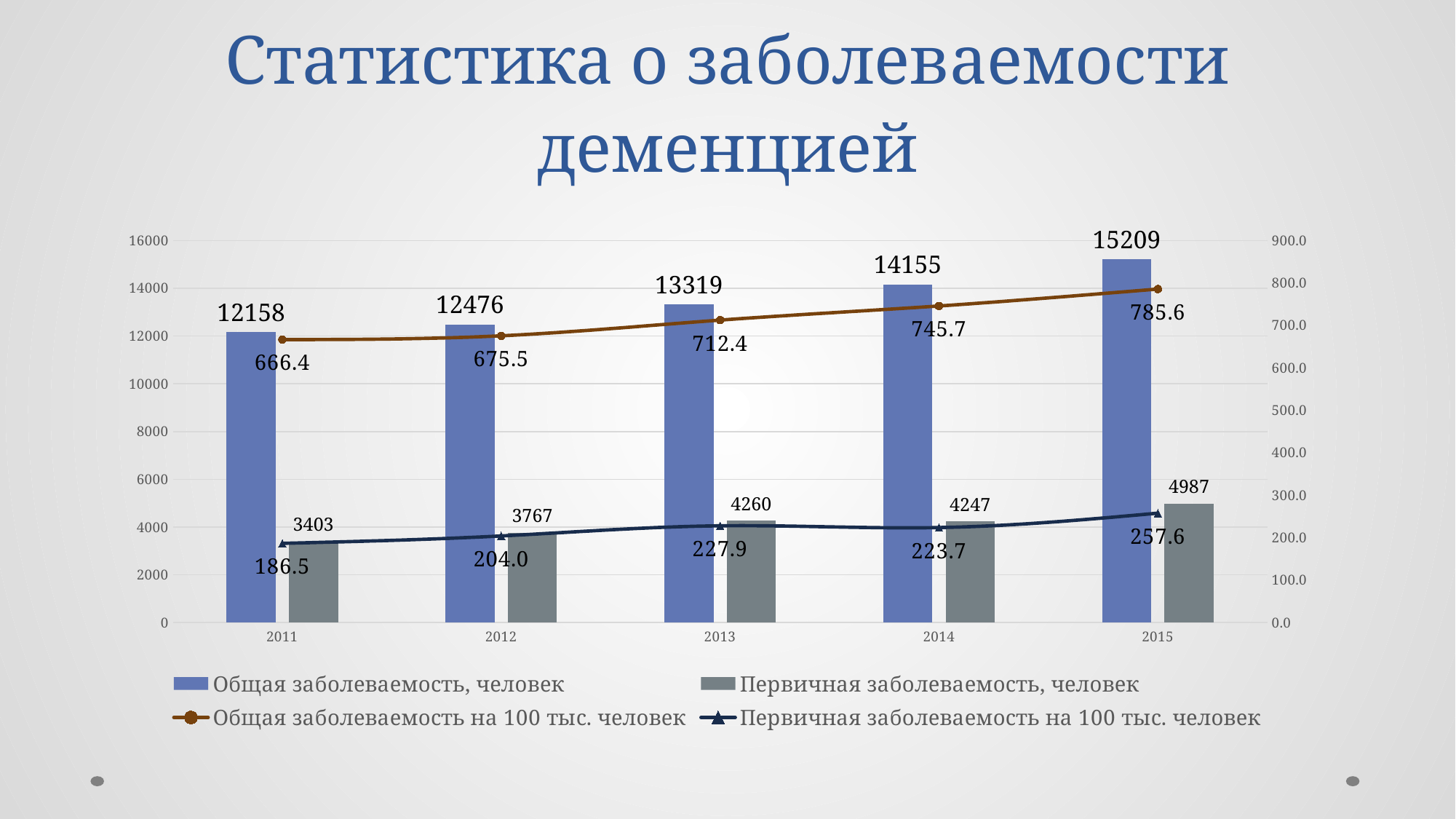
What is the value of "Общая заболеваемость, человек" in 2013? 13319 How many series does the legend list? 4 What is the difference between "Общая заболеваемость, человек" in 2015 and in 2011? 3051 In which year is "Общая заболеваемость, человек" highest? 2015 Which is larger: "Первичная заболеваемость, человек" in 2013 or in 2014? 2013 How many years are shown on the x axis? 5 Does "Общая заболеваемость на 100 тыс. человек" rise or fall from 2011 to 2015? rise What is the title of the slide? Статистика о заболеваемости деменцией What is the value of "Первичная заболеваемость на 100 тыс. человек" in 2014? 223.7 In which year is "Первичная заболеваемость, человек" lowest? 2011 What is the value of "Общая заболеваемость на 100 тыс. человек" in 2011? 666.4 What is the value of "Первичная заболеваемость, человек" in 2015? 4987